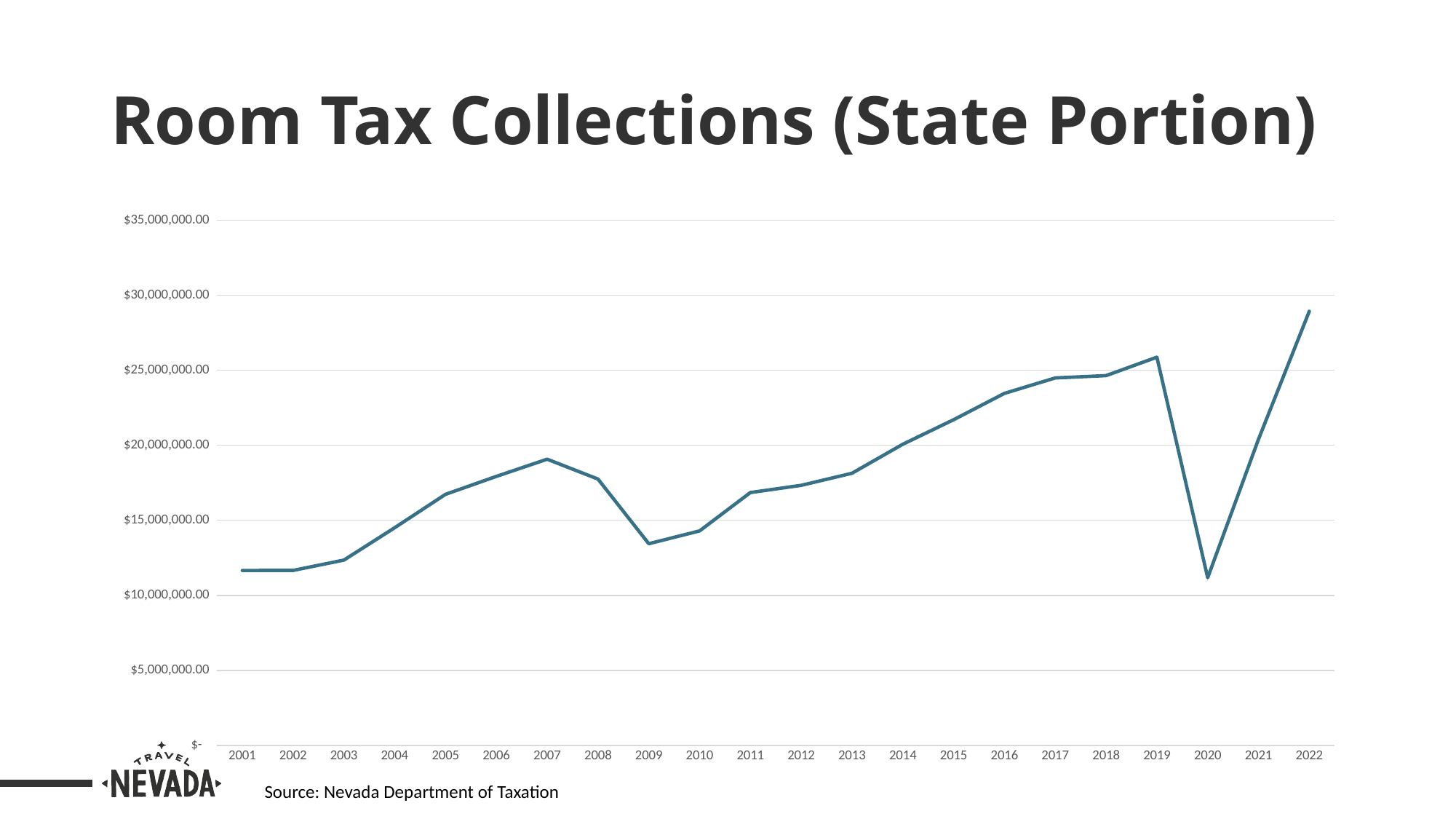
Which year has the lowest room tax collections? 2020 How many years are plotted along the x axis? 22 Which year has the larger value, 2019 or 2022? 2022 Which year has the larger value, 2007 or 2009? 2007 Do the values rise or fall from 2009 to 2019? rise Is the value for 2016 greater or less than $20,000,000.00? greater What kind of chart is shown on the slide? line chart Is the value for 2022 greater or less than $25,000,000.00? greater Is the value for 2009 greater or less than $15,000,000.00? less What is the title of the chart? Room Tax Collections (State Portion) Which year has the highest room tax collections? 2022